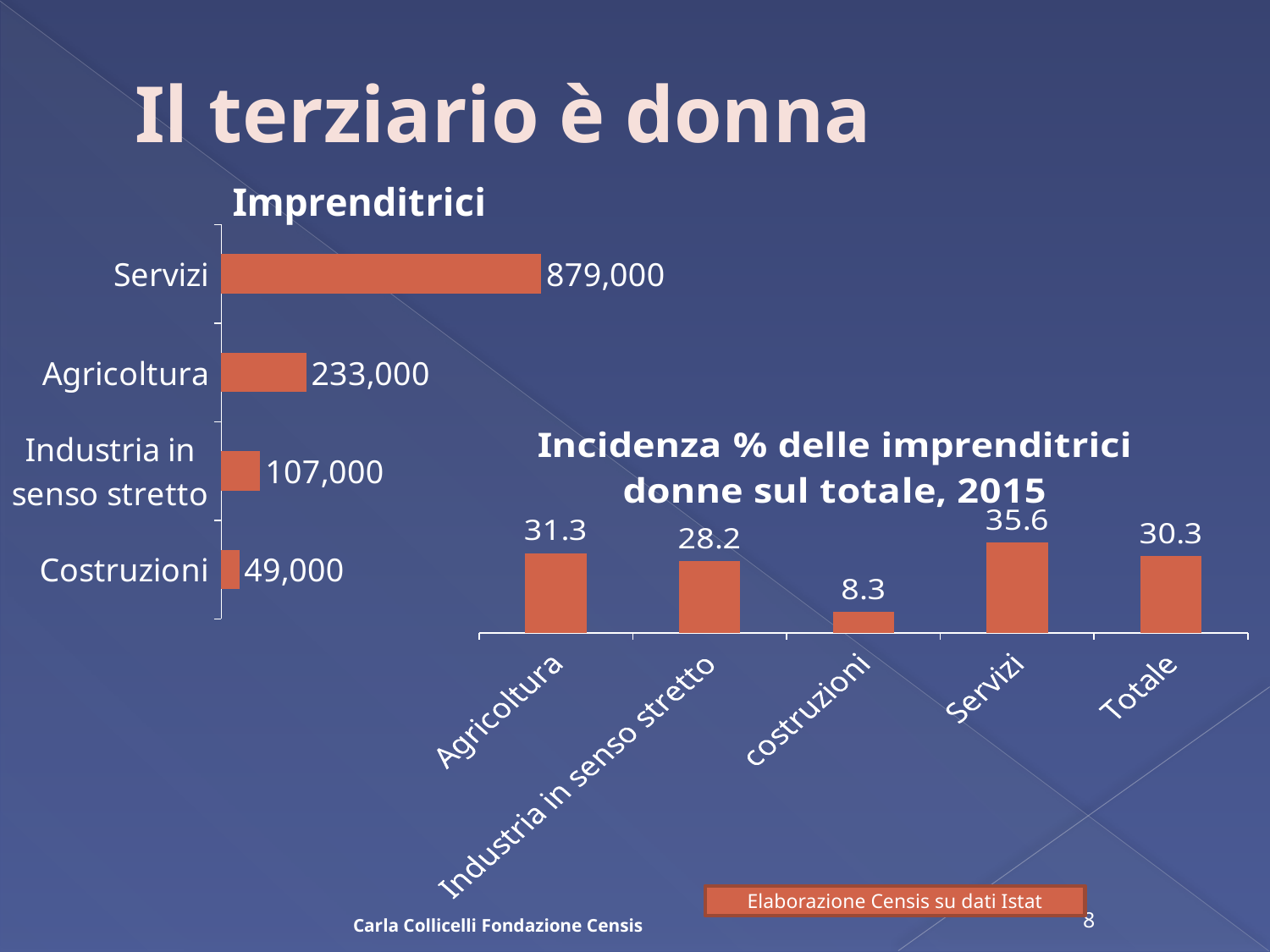
In the 'Incidenza % delle imprenditrici donne sul totale, 2015' chart, what is the value for Totale? 30.3 In the 'Imprenditrici' chart, what is the difference between Agricoltura and Industria in senso stretto? 126,000 What kind of chart is the 'Imprenditrici' chart? Bar chart In the 'Imprenditrici' chart, which category has the lowest value? Costruzioni In the 'Imprenditrici' chart, what is the value for Servizi? 879,000 In the 'Incidenza % delle imprenditrici donne sul totale, 2015' chart, how many categories are shown? 5 In the 'Imprenditrici' chart, which category has the highest value? Servizi In the 'Incidenza % delle imprenditrici donne sul totale, 2015' chart, what is the value for Servizi? 35.6 In the 'Incidenza % delle imprenditrici donne sul totale, 2015' chart, which is larger, Agricoltura or Industria in senso stretto? Agricoltura In the 'Incidenza % delle imprenditrici donne sul totale, 2015' chart, which category has the lowest value? costruzioni In the 'Imprenditrici' chart, how many categories are shown? 4 In the 'Imprenditrici' chart, what is the value for Costruzioni? 49,000